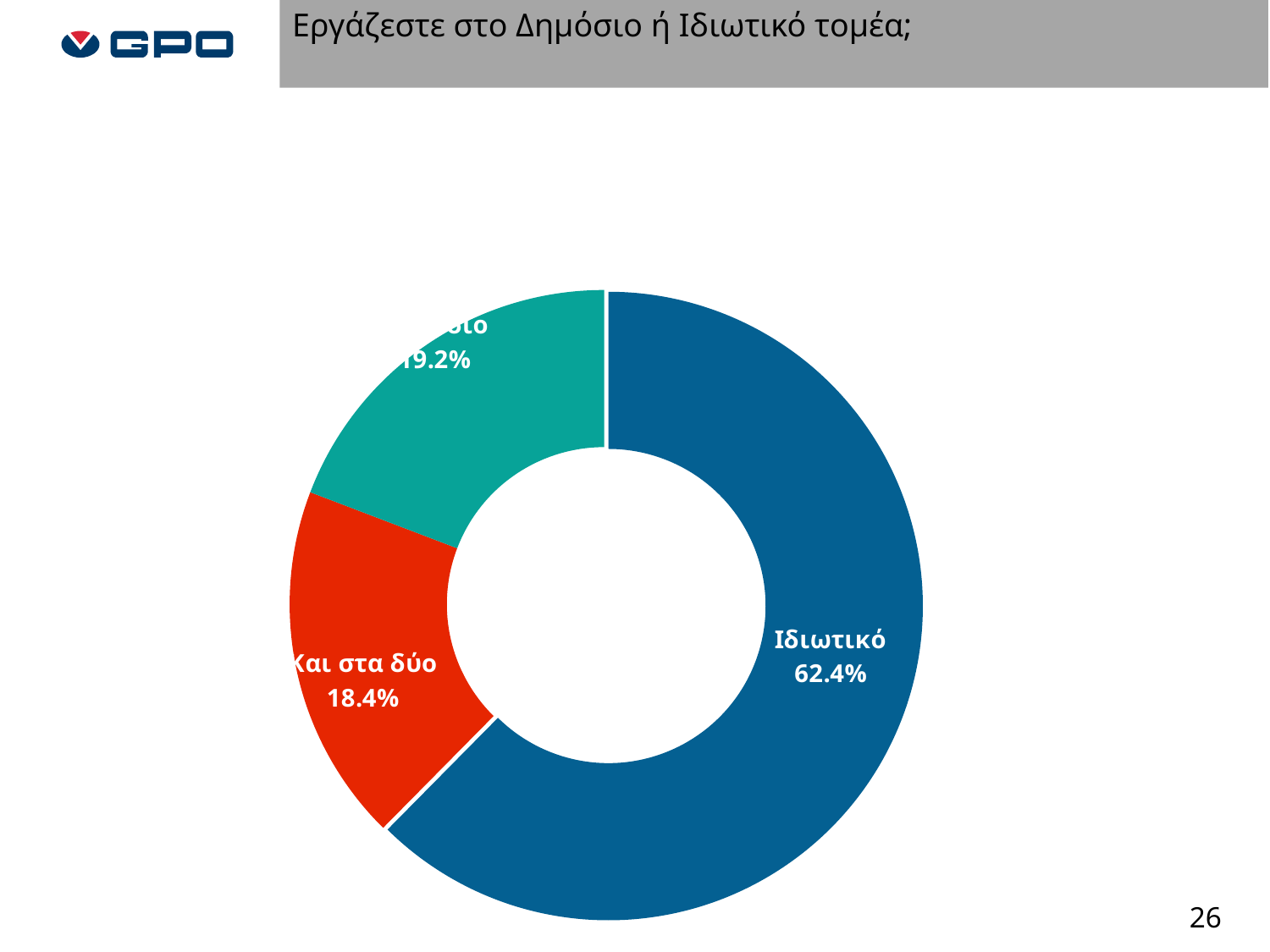
What kind of chart is shown on the slide? Pie chart (donut) How many slices does the pie chart have? 3 What is the title of the slide? Εργάζεστε στο Δημόσιο ή Ιδιωτικό τομέα; Which category has the largest slice of the pie? Ιδιωτικό What share of the pie does Ιδιωτικό have? 62.4% What is the difference between the Ιδιωτικό share and the Και στα δύο share? 44.0% Is the share for Ιδιωτικό greater or less than 50%? greater What colour is the slice for Και στα δύο? Red What share of the pie does Και στα δύο have? 18.4% Which is larger, the slice for Ιδιωτικό or the slice for Και στα δύο? Ιδιωτικό